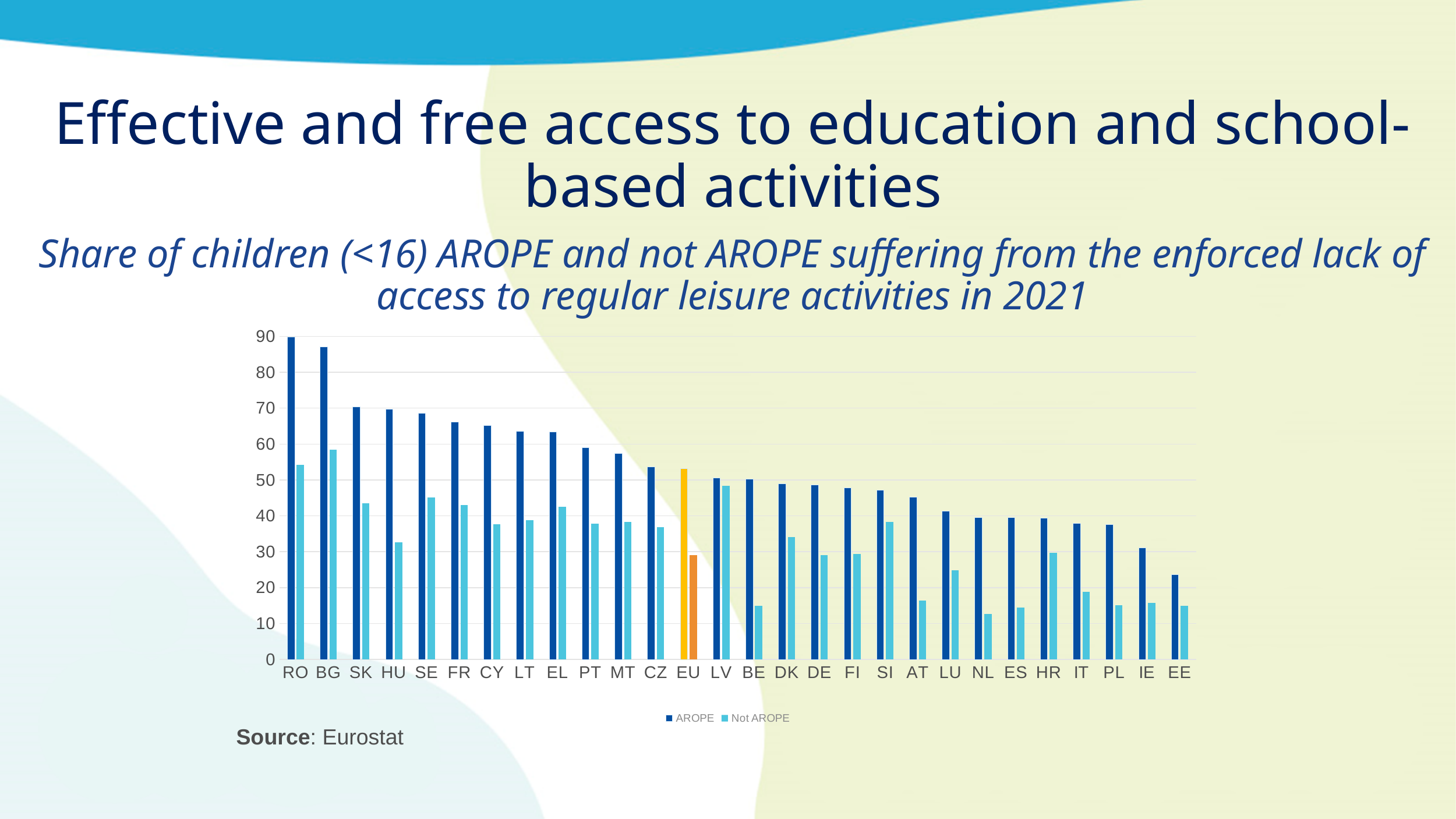
Which is larger for LV: the AROPE value or the Not AROPE value? AROPE Is the AROPE value for RO greater or less than 80? greater Which country has the lowest AROPE value? EE Which country has the highest AROPE value? RO What kind of chart is shown on the slide? bar chart Which category's bars are highlighted in orange/yellow rather than blue? EU Do the AROPE values rise or fall moving from left to right along the x axis? fall How many countries/regions are shown along the x axis? 28 Is the Not AROPE value for HU greater or less than 40? less How many series does the legend list? 2 Is the AROPE value for EE greater or less than 30? less Which country has the highest Not AROPE value? BG